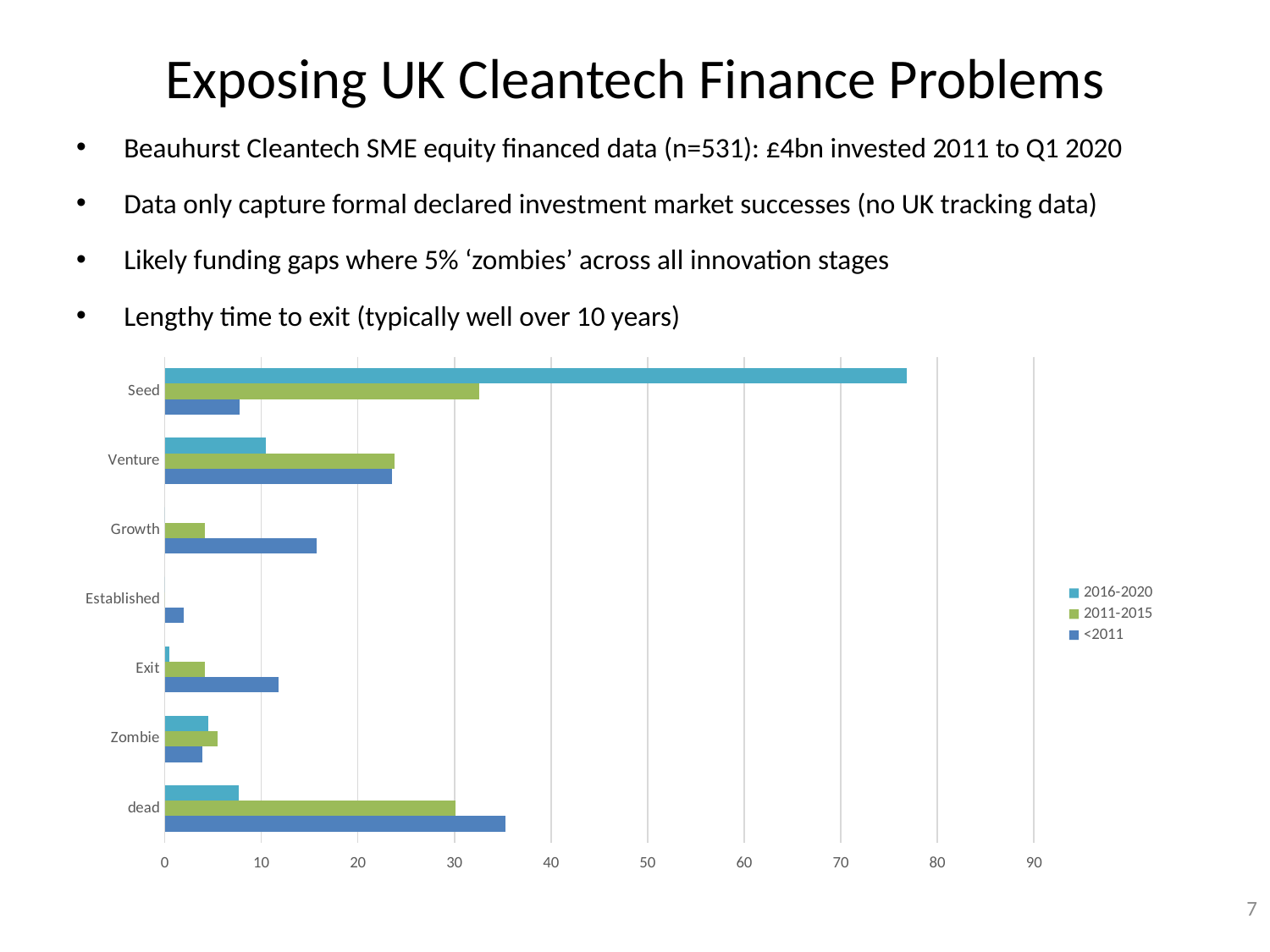
How many categories are shown on the vertical axis of the chart? 7 For Seed, which series has the larger value: 2016-2020 or 2011-2015? 2016-2020 Is the 2016-2020 value for Venture greater or less than 20? less How many series does the chart legend list? 3 Is the <2011 value for Growth greater or less than 10? greater Which category has the highest value for the 2016-2020 series? Seed What kind of chart is shown on the slide? bar chart Is the 2016-2020 value for Seed greater or less than 70? greater Which category has the highest value for the <2011 series? dead For dead, which series has the larger value: <2011 or 2016-2020? <2011 Which category has the lowest value for the <2011 series? Established